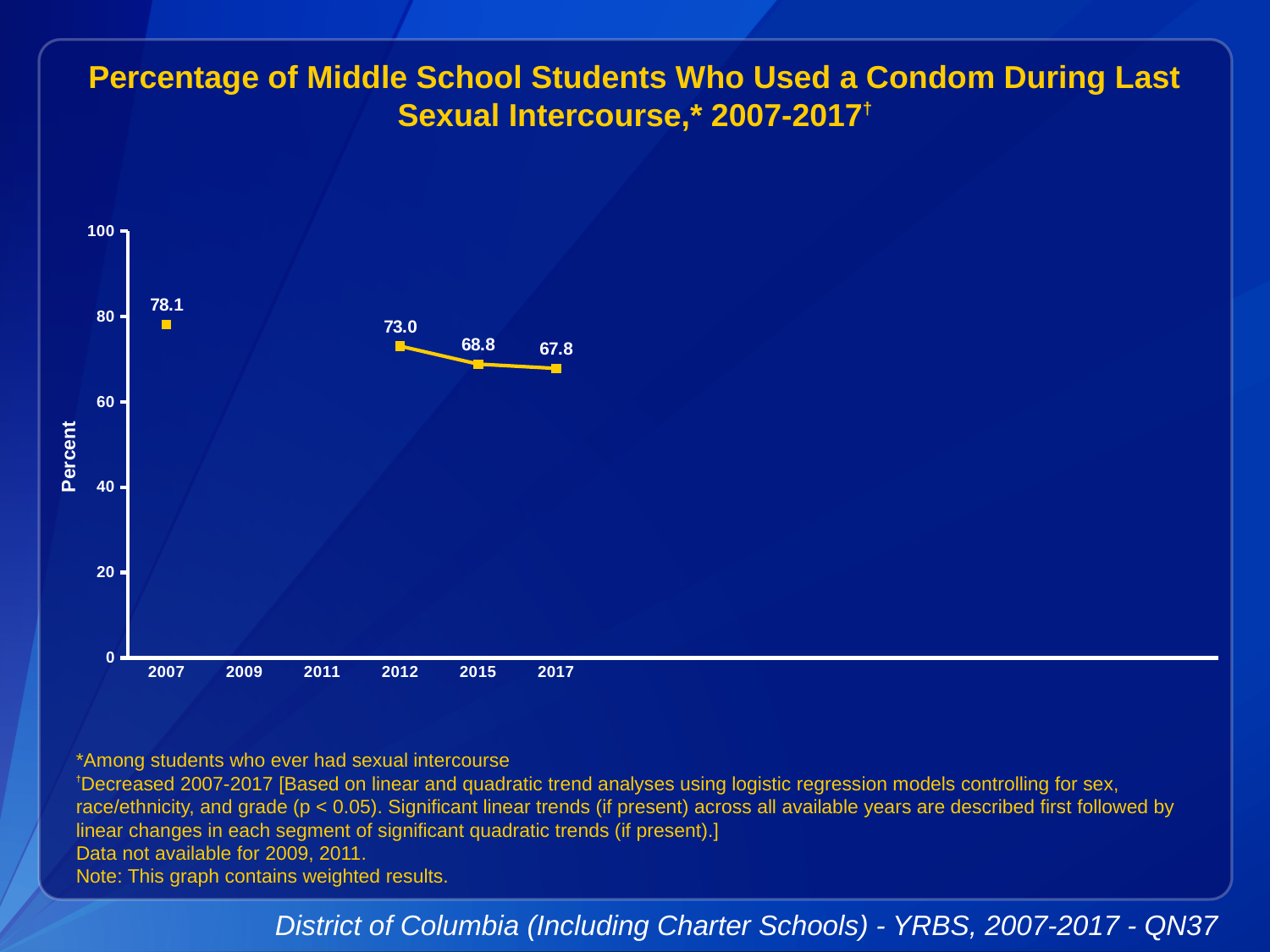
How many years have data points plotted on the chart? 4 Do the plotted values rise or fall from 2007 to 2017? fall Which year has the highest plotted value? 2007 What is the label on the y axis? Percent What is the value plotted for 2017? 67.8 Which year has the lowest plotted value? 2017 What is the difference between the 2007 value and the 2017 value? 10.3 What is the value plotted for 2012? 73.0 What is the difference between the 2012 value and the 2015 value? 4.2 Which is larger, the value for 2012 or the value for 2015? 2012 What is the value plotted for 2015? 68.8 What percentage of middle school students used a condom during last sexual intercourse in 2007? 78.1